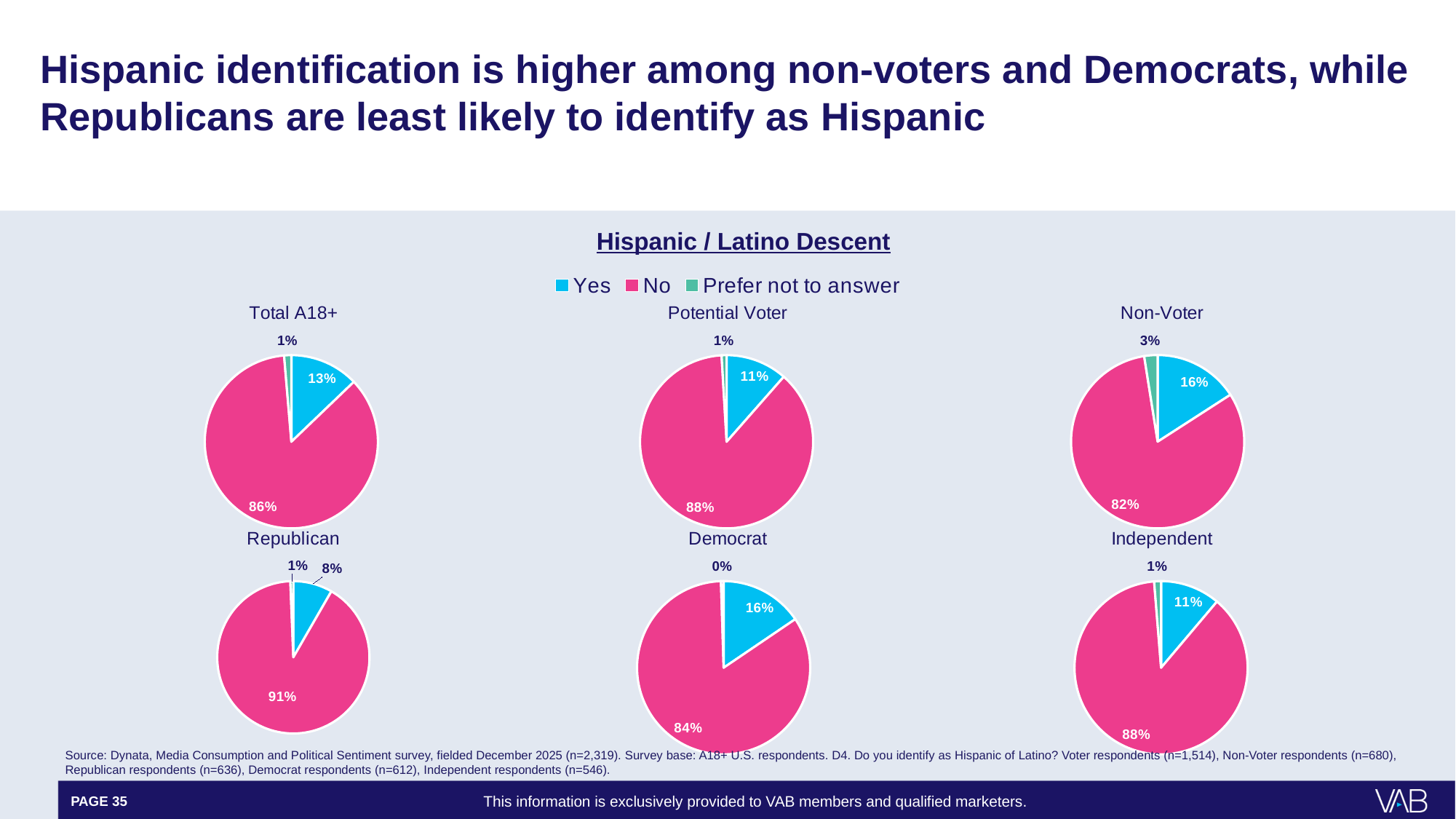
Across the six pie charts, which group has the lowest Yes share? Republican In the Republican pie chart, what share of respondents answered Yes? 8% Across the six pie charts, which group has the highest Yes share? Non-Voter and Democrat (16%) In the Non-Voter pie chart, what share of respondents chose Prefer not to answer? 3% What is the difference between the No share in the Republican pie chart and the No share in the Non-Voter pie chart? 9 percentage points In the Independent pie chart, what share of respondents answered Yes? 11% In the Total A18+ pie chart, what share of respondents answered Yes? 13% In the Democrat pie chart, what share of respondents answered No? 84% How many series does the legend list for the pie charts? 3 In the Potential Voter pie chart, what share of respondents answered No? 88% Which is larger: the Yes share in the Democrat pie chart or the Yes share in the Potential Voter pie chart? Democrat What type of chart is used to show Hispanic / Latino Descent on this slide? Pie chart